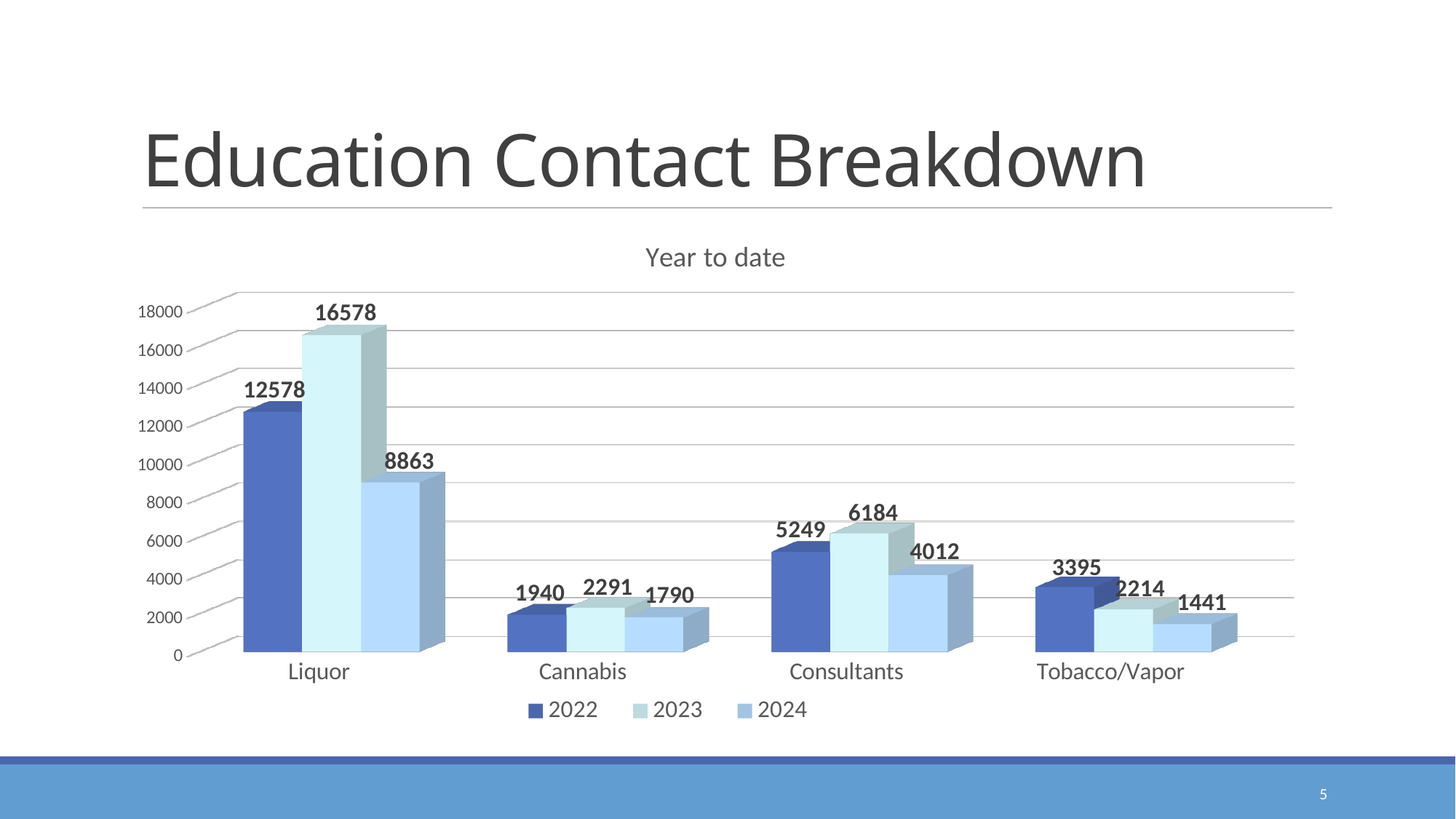
What is the value for Consultants in 2024? 4012 What is the title of the chart? Year to date How many series does the legend list? 3 Which is larger for Cannabis: the 2022 value or the 2023 value? 2023 What kind of chart is shown? Bar chart What is the difference between the 2023 and 2024 values for Liquor? 7715 Do the values for Tobacco/Vapor rise or fall from 2022 to 2024? Fall How many categories are shown on the x axis? 4 What is the value for Liquor in 2023? 16578 Which category has the lowest value in 2024? Tobacco/Vapor Which category has the highest value in 2022? Liquor What is the value for Tobacco/Vapor in 2022? 3395